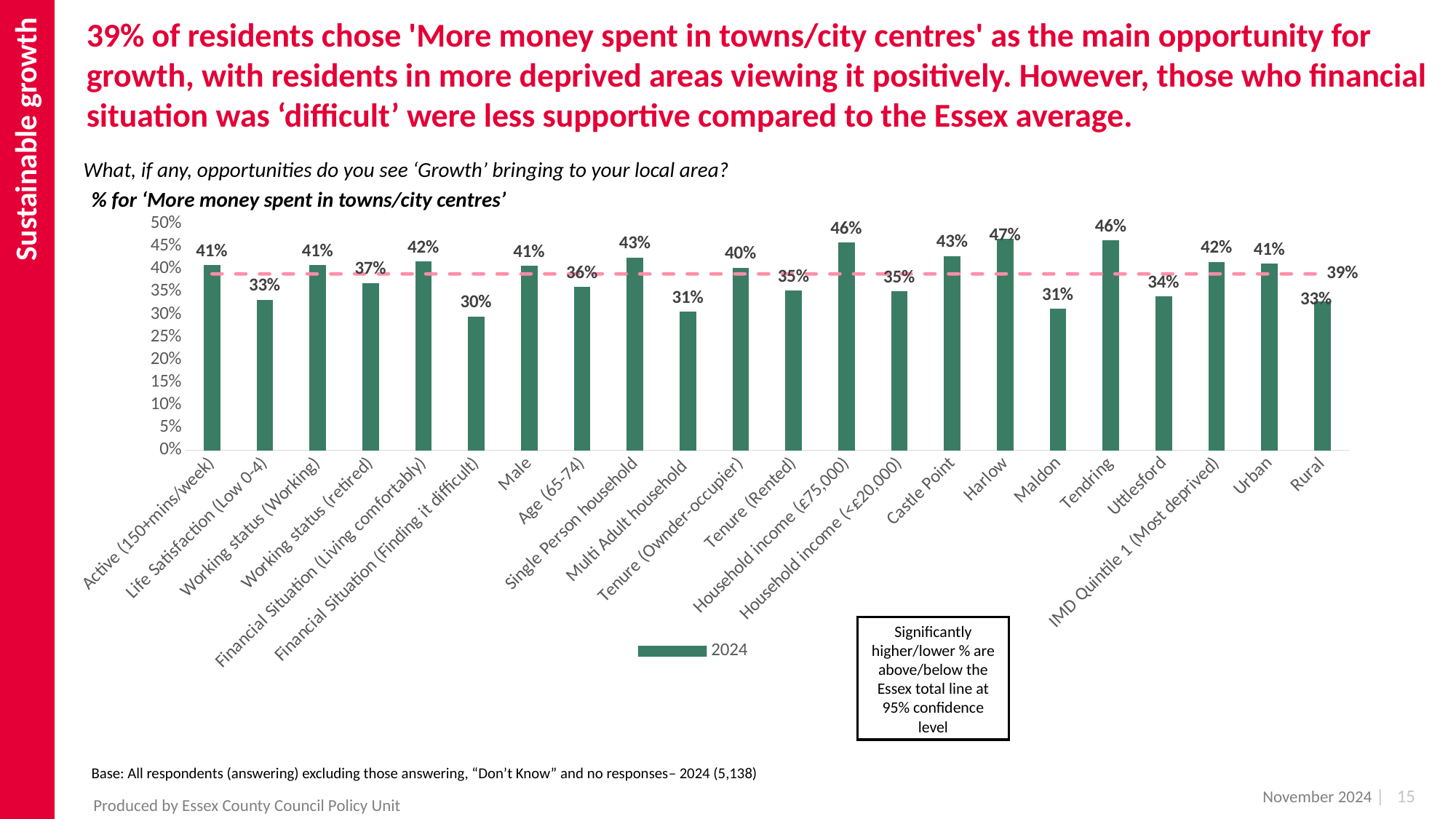
What value does the dashed horizontal line represent? 39% Which category has the highest value? Harlow Is the value for Multi Adult household greater or less than 35%? less How many series does the legend list? 1 What is the value for IMD Quintile 1 (Most deprived)? 42% Which is larger, the value for Castle Point or the value for Maldon? Castle Point How many categories are shown on the x axis? 22 What is the value for Tenure (Rented)? 35% Which category has the lowest value? Financial Situation (Finding it difficult) What is the difference between the values for Tendring and Uttlesford? 12% What is the value for Harlow? 47% What is the value for Financial Situation (Finding it difficult)? 30%